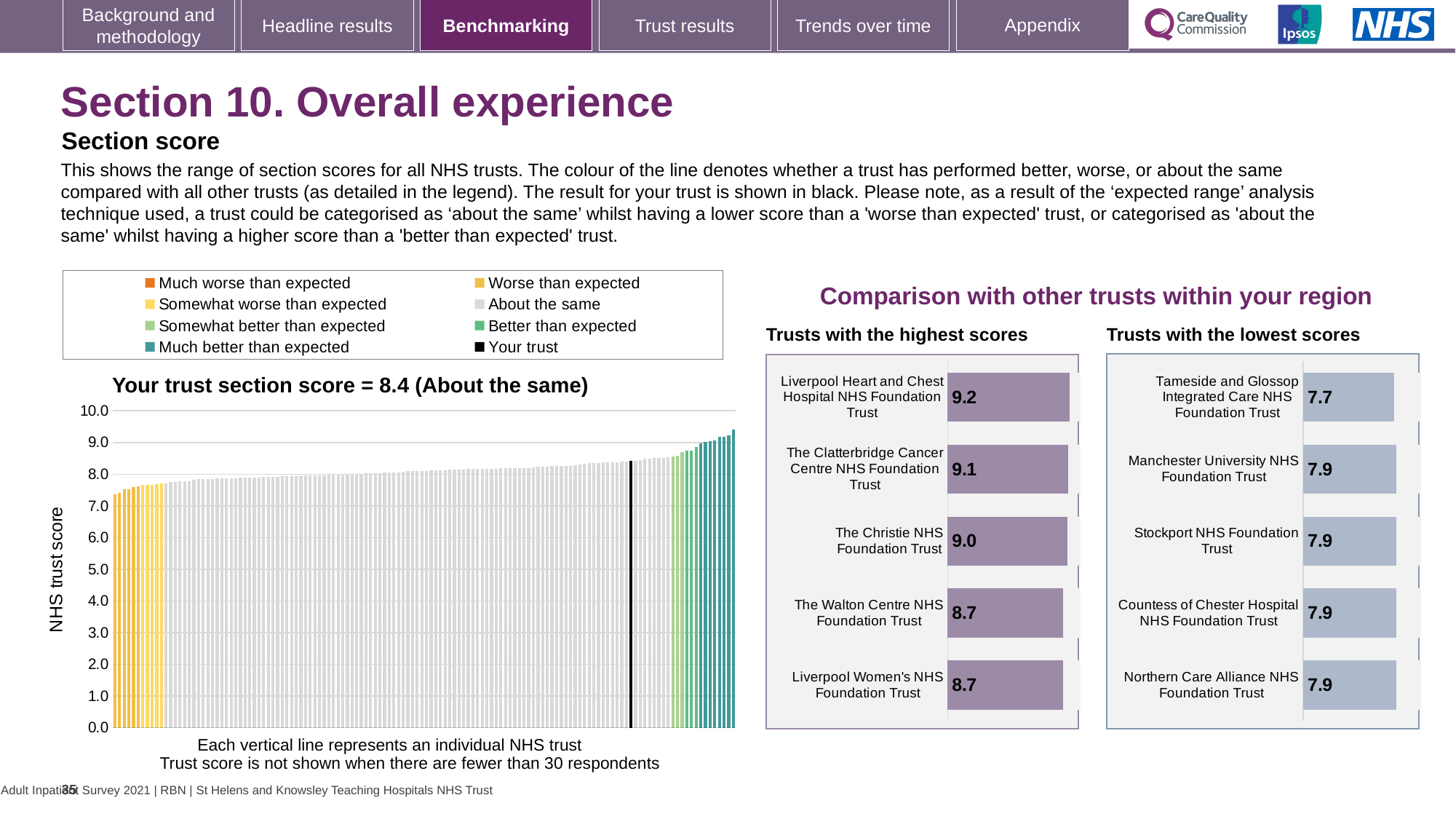
In the 'Trusts with the highest scores' chart, which has the larger score: The Clatterbridge Cancer Centre NHS Foundation Trust or Liverpool Women's NHS Foundation Trust? The Clatterbridge Cancer Centre NHS Foundation Trust In the 'Trusts with the lowest scores' chart, what is the difference between the scores of Stockport NHS Foundation Trust and Tameside and Glossop Integrated Care NHS Foundation Trust? 0.2 In the 'Trusts with the highest scores' chart, what is the score for The Christie NHS Foundation Trust? 9.0 In the 'Trusts with the lowest scores' chart, what is the score for Tameside and Glossop Integrated Care NHS Foundation Trust? 7.7 In the 'Your trust section score' chart, what is the section score for your trust? 8.4 In the 'Trusts with the highest scores' chart, which trust has the highest score? Liverpool Heart and Chest Hospital NHS Foundation Trust In the 'Your trust section score' chart, do the bar values rise or fall from left to right? rise In the 'Your trust section score' chart, is the value of the leftmost (lowest) bar greater or less than 8.0? less How many trusts are listed in the 'Trusts with the lowest scores' chart? 5 In the 'Trusts with the highest scores' chart, what is the difference between the scores of Liverpool Heart and Chest Hospital NHS Foundation Trust and The Walton Centre NHS Foundation Trust? 0.5 In the 'Trusts with the highest scores' chart, what is the score for Liverpool Heart and Chest Hospital NHS Foundation Trust? 9.2 In the 'Trusts with the lowest scores' chart, which trust has the lowest score? Tameside and Glossop Integrated Care NHS Foundation Trust